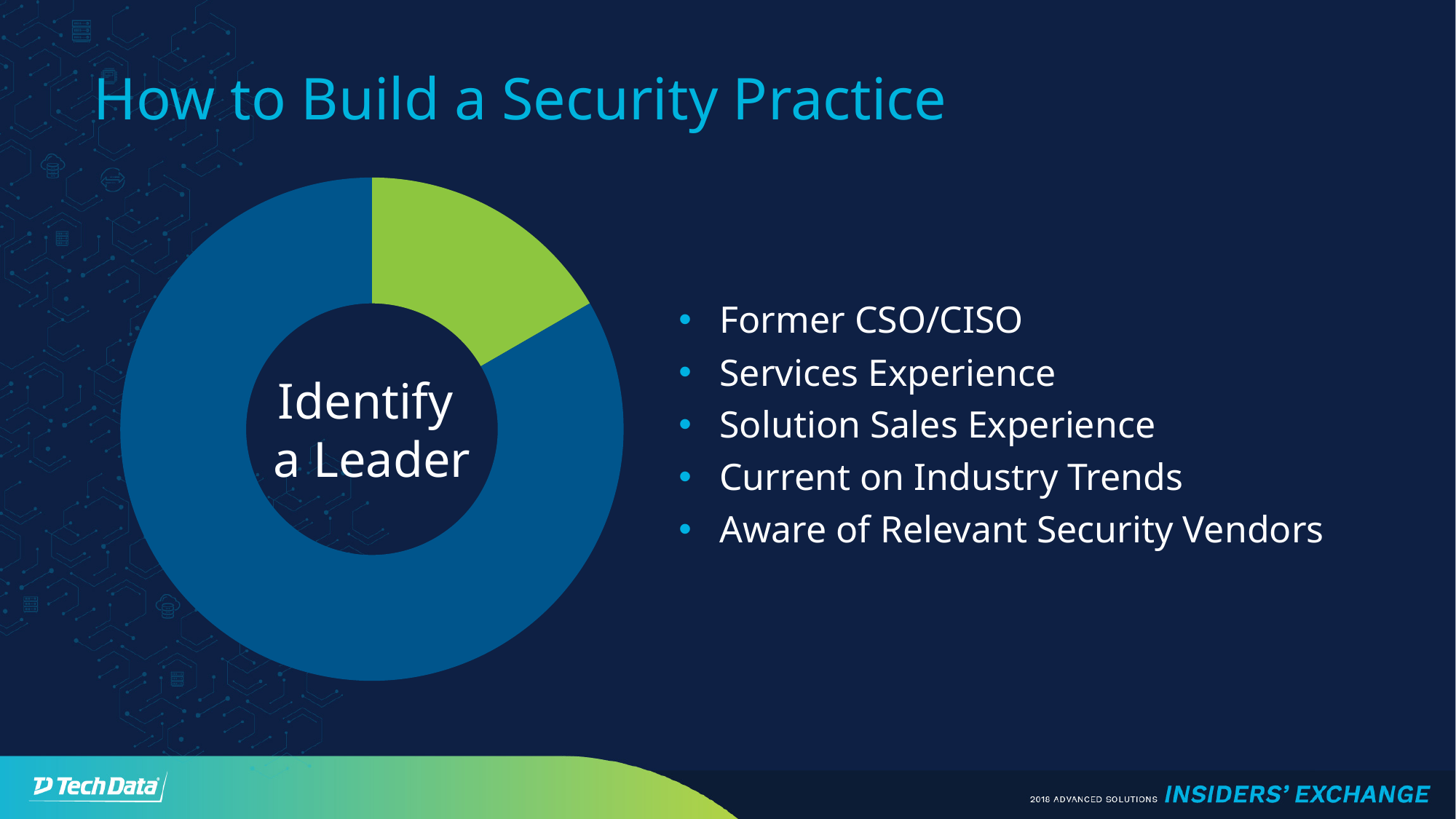
What colour is the larger slice of the doughnut chart? blue Which slice of the doughnut chart is larger, the green one or the blue one? the blue one Which slice of the doughnut chart is the smallest? the green slice What kind of chart is shown on the slide? doughnut chart How many slices does the doughnut chart have? 2 What text appears in the centre of the doughnut chart? Identify a Leader